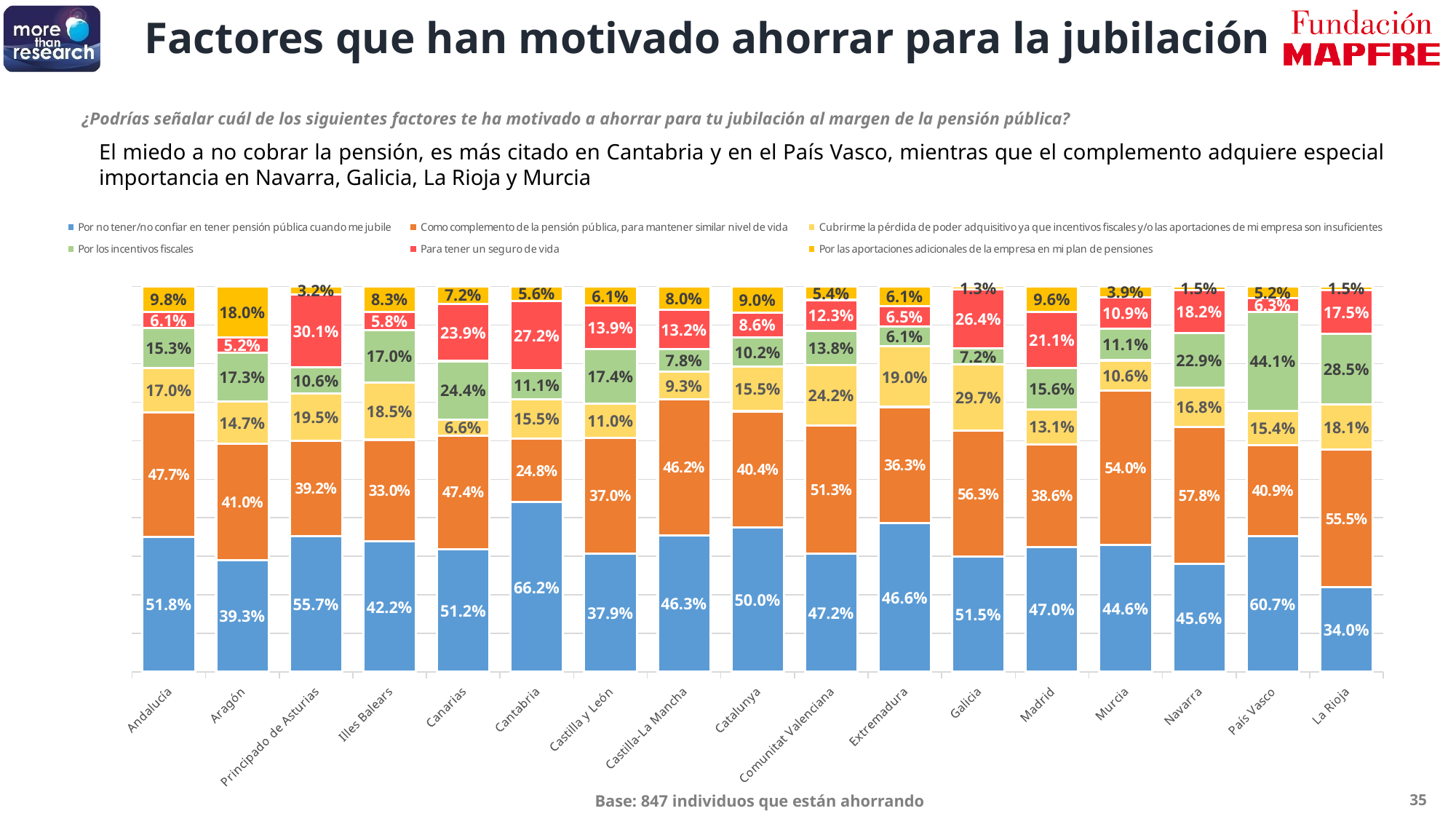
What is the value for Navarra in the series 'Como complemento de la pensión pública, para mantener similar nivel de vida'? 57.8% What is the value for Cantabria in the series 'Por no tener/no confiar en tener pensión pública cuando me jubile'? 66.2% How many regions (categories) are shown on the x axis of the chart? 17 What is the value for País Vasco in the series 'Por los incentivos fiscales'? 44.1% In the series 'Como complemento de la pensión pública, para mantener similar nivel de vida', which is larger: Andalucía or Aragón? Andalucía What is the difference in percentage points between Cantabria and La Rioja in the series 'Por no tener/no confiar en tener pensión pública cuando me jubile'? 32.2 percentage points Which region has the lowest value in the series 'Por no tener/no confiar en tener pensión pública cuando me jubile'? La Rioja What kind of chart is shown on the slide? Stacked bar chart Which region has the highest value in the series 'Por no tener/no confiar en tener pensión pública cuando me jubile'? Cantabria How many series does the legend of the chart list? 6 Which region has the highest value in the series 'Por las aportaciones adicionales de la empresa en mi plan de pensiones'? Aragón What is the value for Principado de Asturias in the series 'Para tener un seguro de vida'? 30.1%